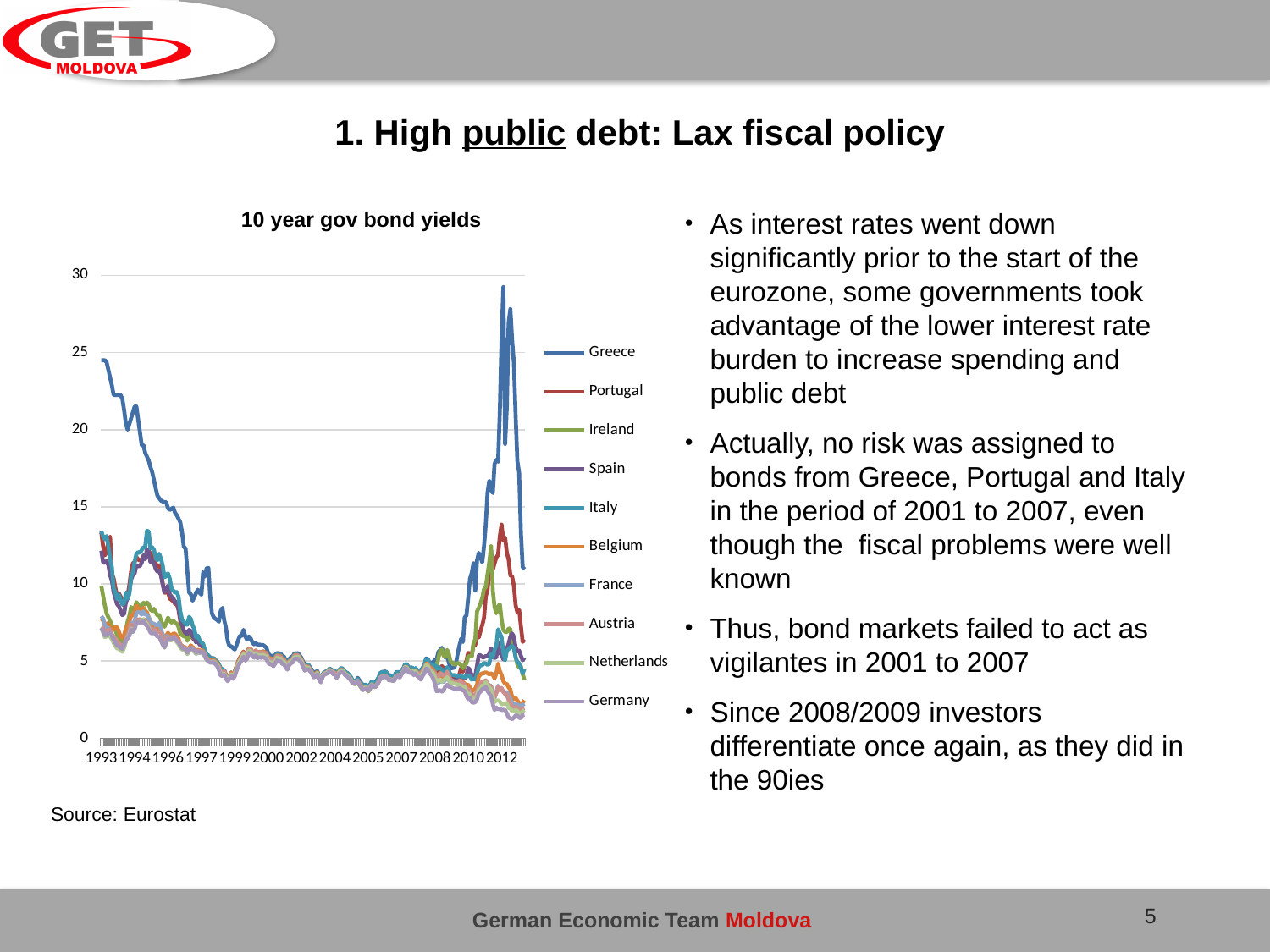
Is the value for Greece in 2005 greater or less than 10? less What kind of chart is shown on the slide? line chart Is the peak value for Greece around 2012 greater or less than 25? greater Do the bond yields for Greece rise or fall between 1993 and 2000? fall Is the value for Greece at the start of 1993 greater or less than 20? greater What is the title of the chart? 10 year gov bond yields Around 2012, which is larger: the bond yield for Greece or for Germany? Greece How many series does the legend of the chart list? 10 Which country's line reaches the highest value on the chart? Greece What is the highest value shown on the vertical axis of the chart? 30